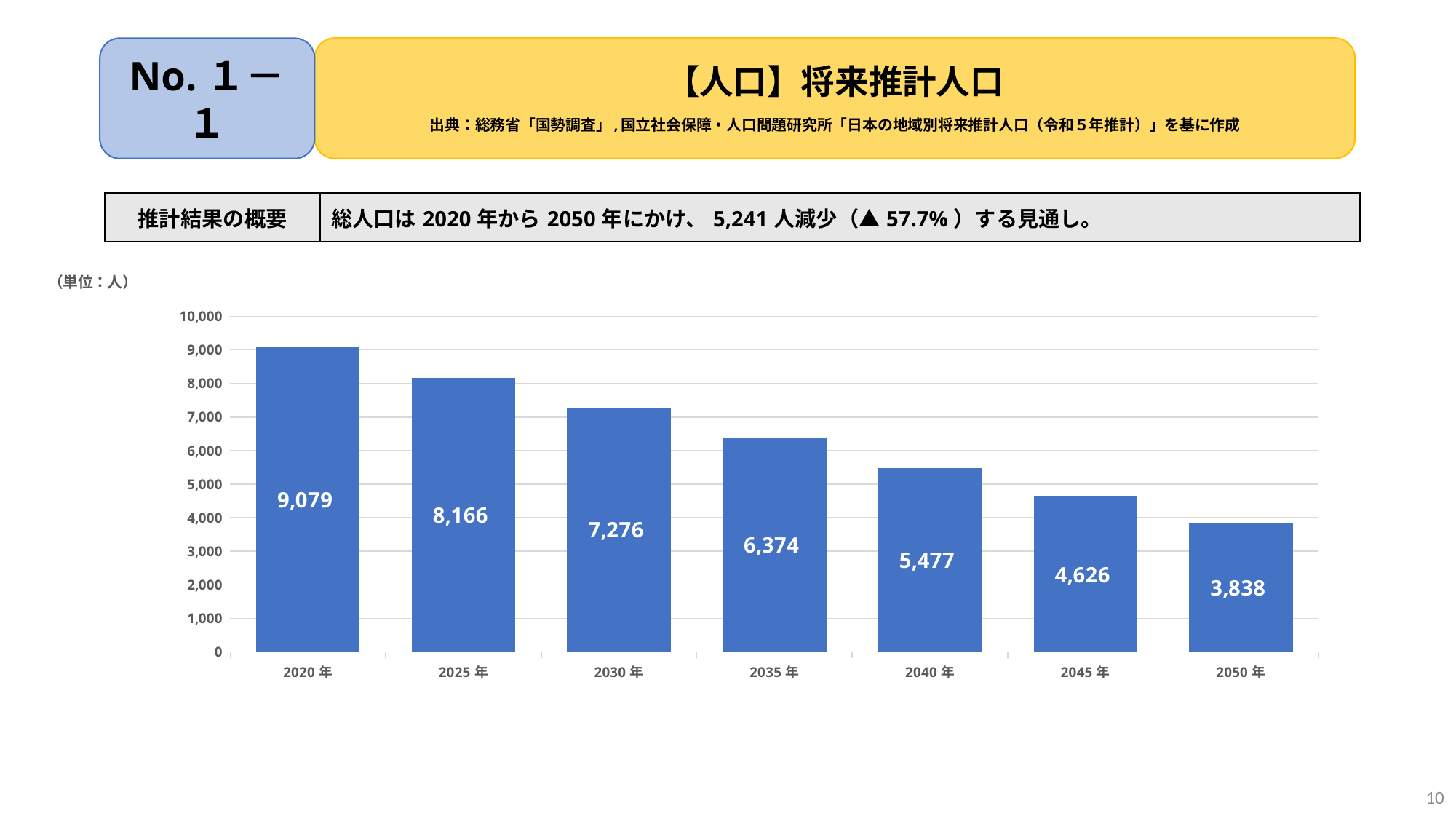
What is the projected population for 2020年? 9,079 What is the difference between the projected population in 2025年 and 2030年? 890 Which year has the highest projected population? 2020年 Which year has the lowest projected population? 2050年 Do the projected population values rise or fall from 2020年 to 2050年? fall Which is larger, the projected population for 2040年 or for 2045年? 2040年 What is the projected population for 2035年? 6,374 How many years are shown on the x axis of the chart? 7 What kind of chart is shown on the slide? bar chart What is the difference between the projected population in 2020年 and 2050年? 5,241 What is the projected population for 2050年? 3,838 Is the value for 2030年 greater or less than 7,000? greater